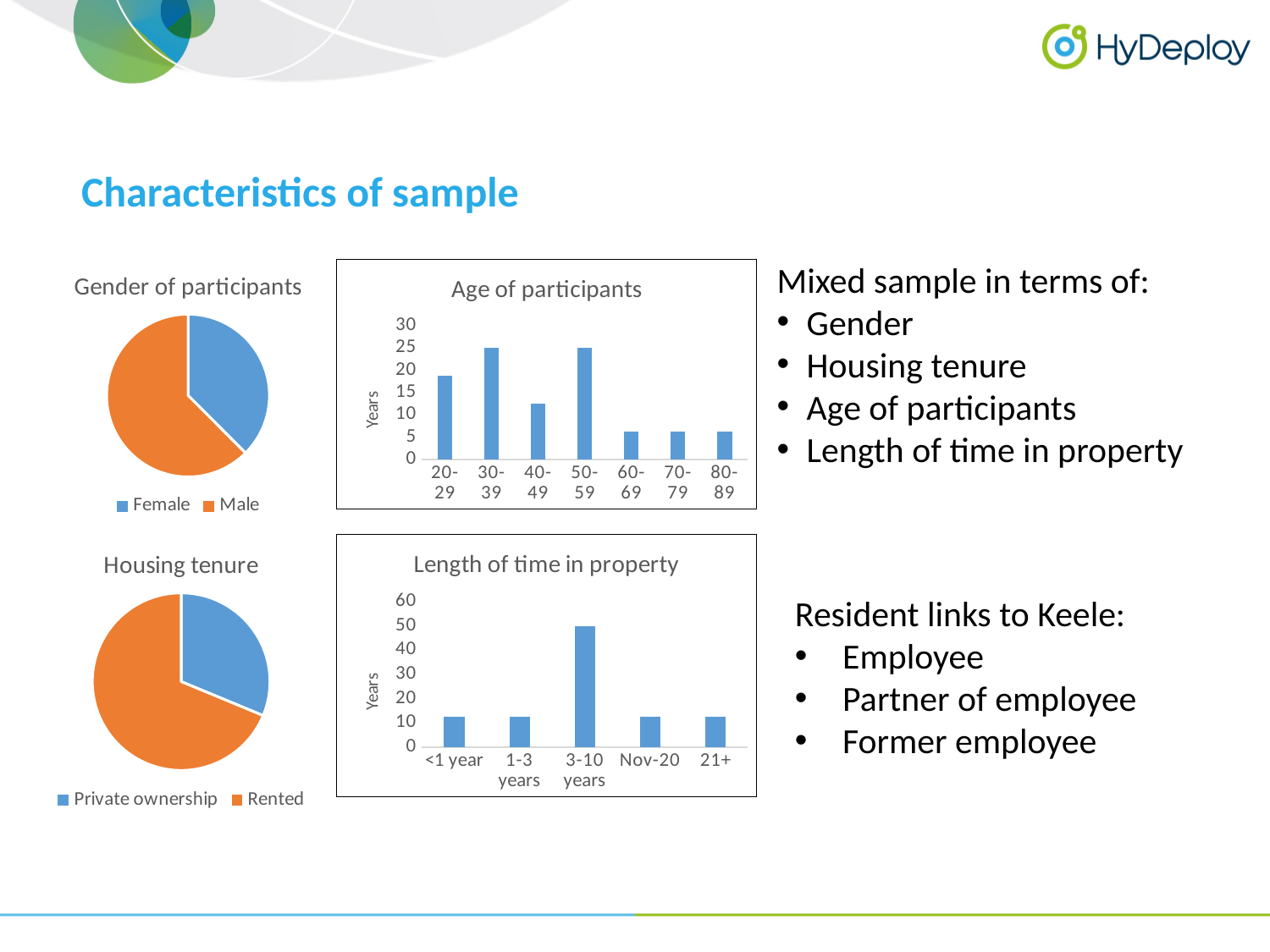
In the 'Age of participants' chart, which is larger, the value for '30-39' or '40-49'? 30-39 In the 'Age of participants' chart, is the value for '40-49' greater or less than 15? less In the 'Gender of participants' chart, which slice is larger, Female or Male? Male In the 'Housing tenure' chart, which slice is larger, Private ownership or Rented? Rented How many categories are shown in the 'Length of time in property' chart? 5 In the 'Length of time in property' chart, is the value for '3-10 years' greater or less than 40? greater How many age categories are shown in the 'Age of participants' chart? 7 In the 'Length of time in property' chart, which category has the highest value? 3-10 years What kind of chart is the 'Age of participants' chart? bar chart In the 'Age of participants' chart, is the value for '20-29' greater or less than 15? greater What kind of chart is the 'Gender of participants' chart? pie chart In the 'Gender of participants' chart, how many entries does the legend list? 2